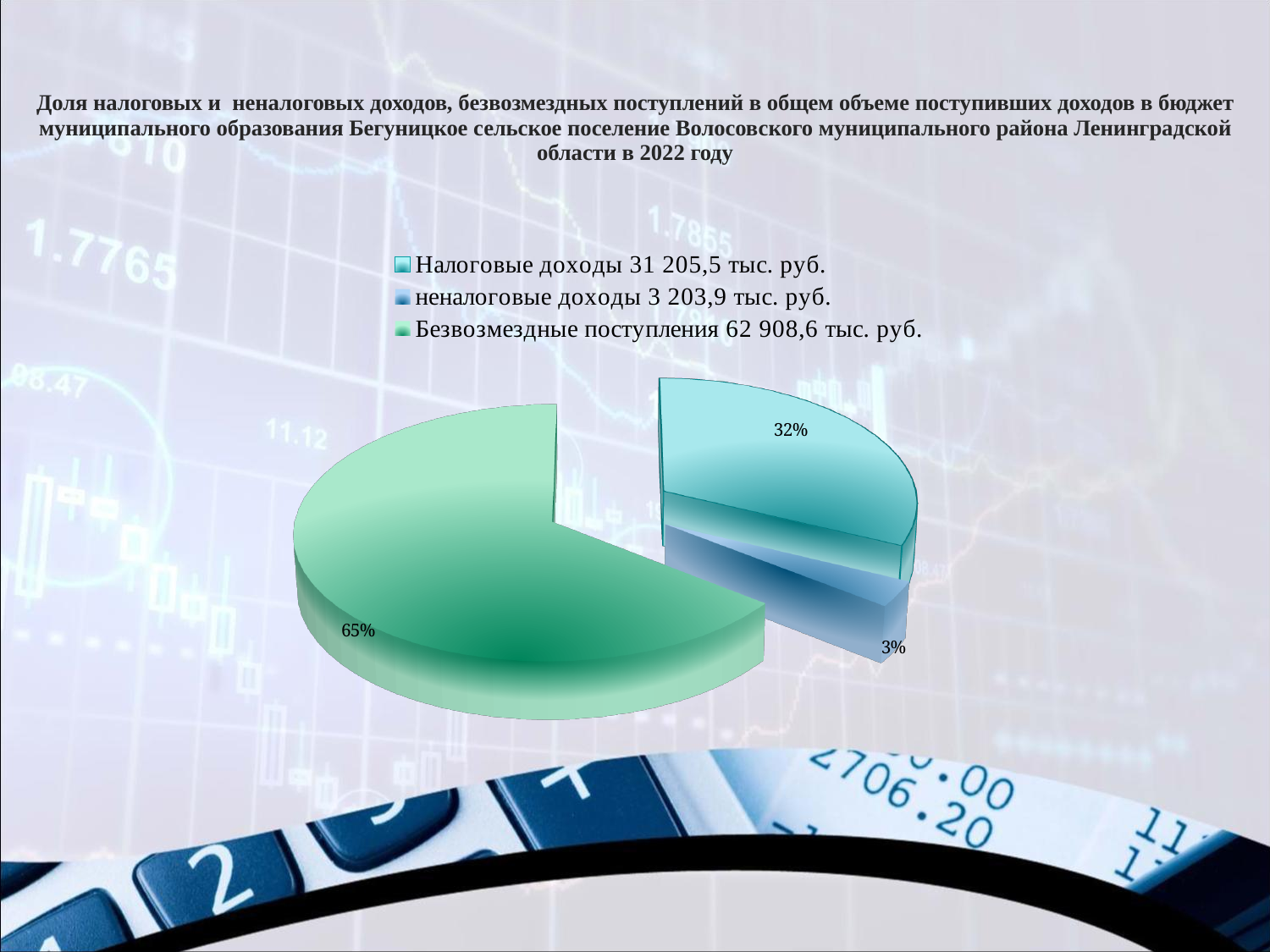
What share of the pie is labelled for Налоговые доходы? 32% What share of the pie is labelled for Безвозмездные поступления? 65% What kind of chart is shown on the slide? pie chart What share of the pie is labelled for неналоговые доходы? 3% What amount in тыс. руб. does the legend give for неналоговые доходы? 3 203,9 тыс. руб. Which category has the largest slice of the pie? Безвозмездные поступления Which category has the smallest slice of the pie? неналоговые доходы By how many percentage points does the share of Безвозмездные поступления exceed the share of Налоговые доходы? 33 What amount in тыс. руб. does the legend give for Налоговые доходы? 31 205,5 тыс. руб. Which is larger: the share of Налоговые доходы or the share of неналоговые доходы? Налоговые доходы How many slices does the pie chart have? 3 How many entries does the legend list? 3